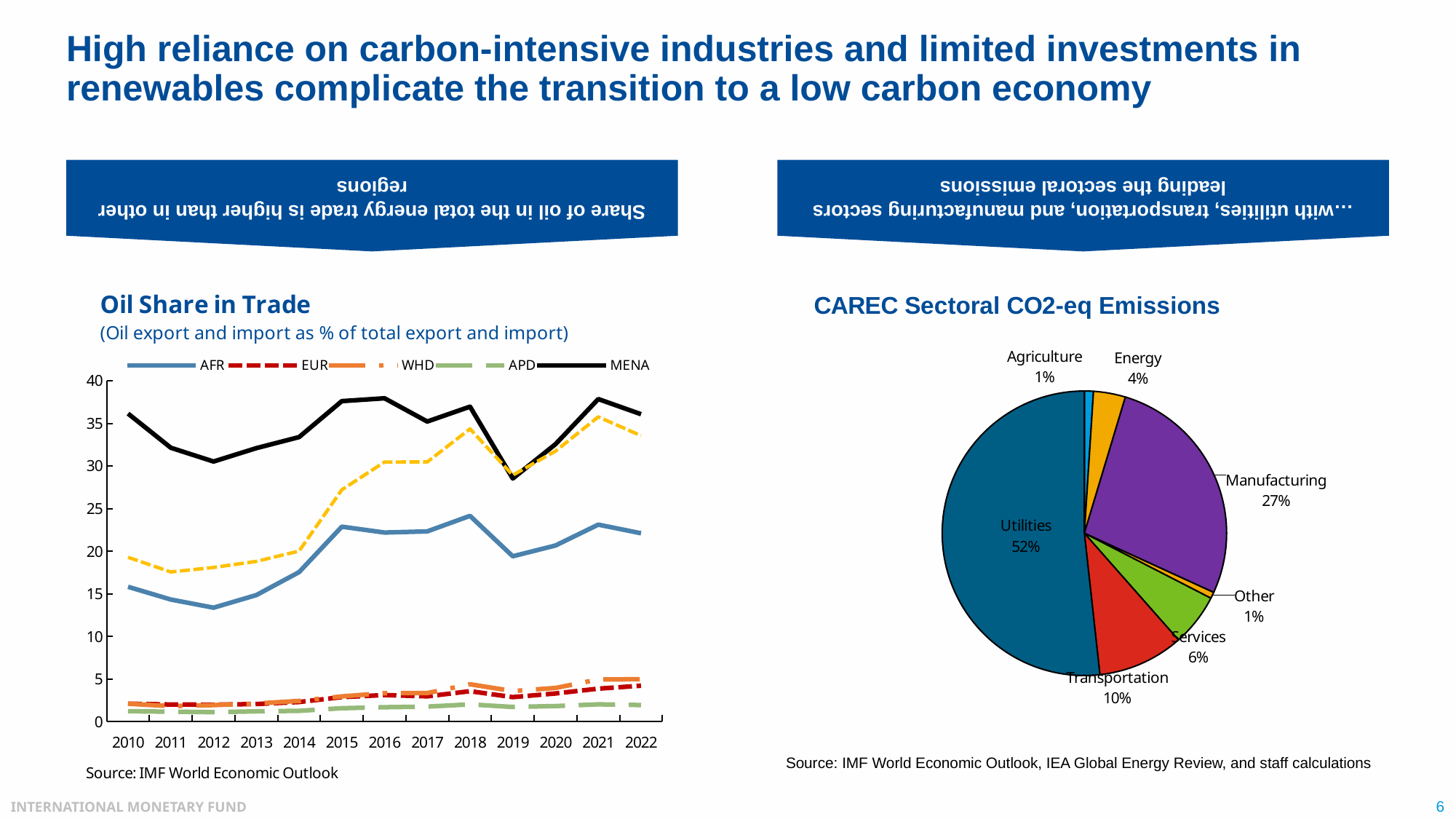
How many series does the legend of the Oil Share in Trade chart list? 5 In the CAREC Sectoral CO2-eq Emissions pie chart, what share of emissions comes from Utilities? 52% In the Oil Share in Trade chart, how many years are shown on the x axis? 13 In the Oil Share in Trade chart, is the value for MENA in 2010 greater or less than 30? greater What type of chart is the Oil Share in Trade chart? Line chart In the Oil Share in Trade chart, is the value for AFR in 2012 greater or less than 15? less In the CAREC Sectoral CO2-eq Emissions pie chart, which sector has the largest share? Utilities In the CAREC Sectoral CO2-eq Emissions pie chart, which is larger, the Services share or the Energy share? Services In the Oil Share in Trade chart, which series has the highest value in 2010? MENA In the CAREC Sectoral CO2-eq Emissions pie chart, what is the difference between the Manufacturing share and the Transportation share? 17% In the CAREC Sectoral CO2-eq Emissions pie chart, what share of emissions comes from Manufacturing? 27% How many sectors are shown in the CAREC Sectoral CO2-eq Emissions pie chart? 7